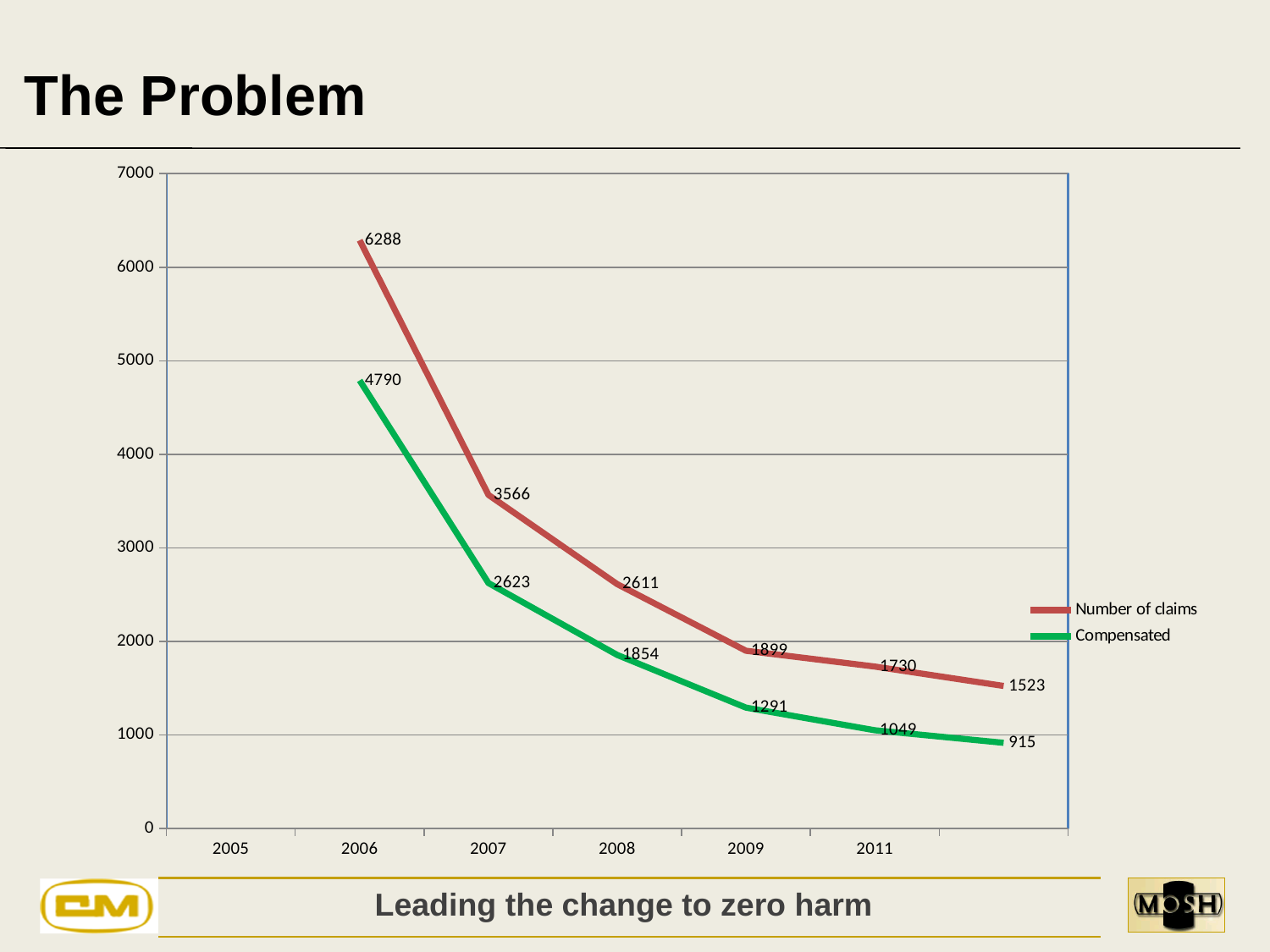
Do the values of the Number of claims series rise or fall along the x axis? fall What is the highest value plotted for the Number of claims series? 6288 In 2009, which series has the larger value, Number of claims or Compensated? Number of claims What is the difference between Number of claims and Compensated in 2006? 1498 How many series does the legend list? 2 What is the value of Number of claims in 2006? 6288 What is the value of Number of claims in 2011? 1730 How many data points are plotted for the Compensated series? 6 What kind of chart is shown on the slide? line chart What is the difference between Number of claims and Compensated in 2008? 757 What is the Compensated value in 2007? 2623 What is the lowest value plotted for the Compensated series? 915